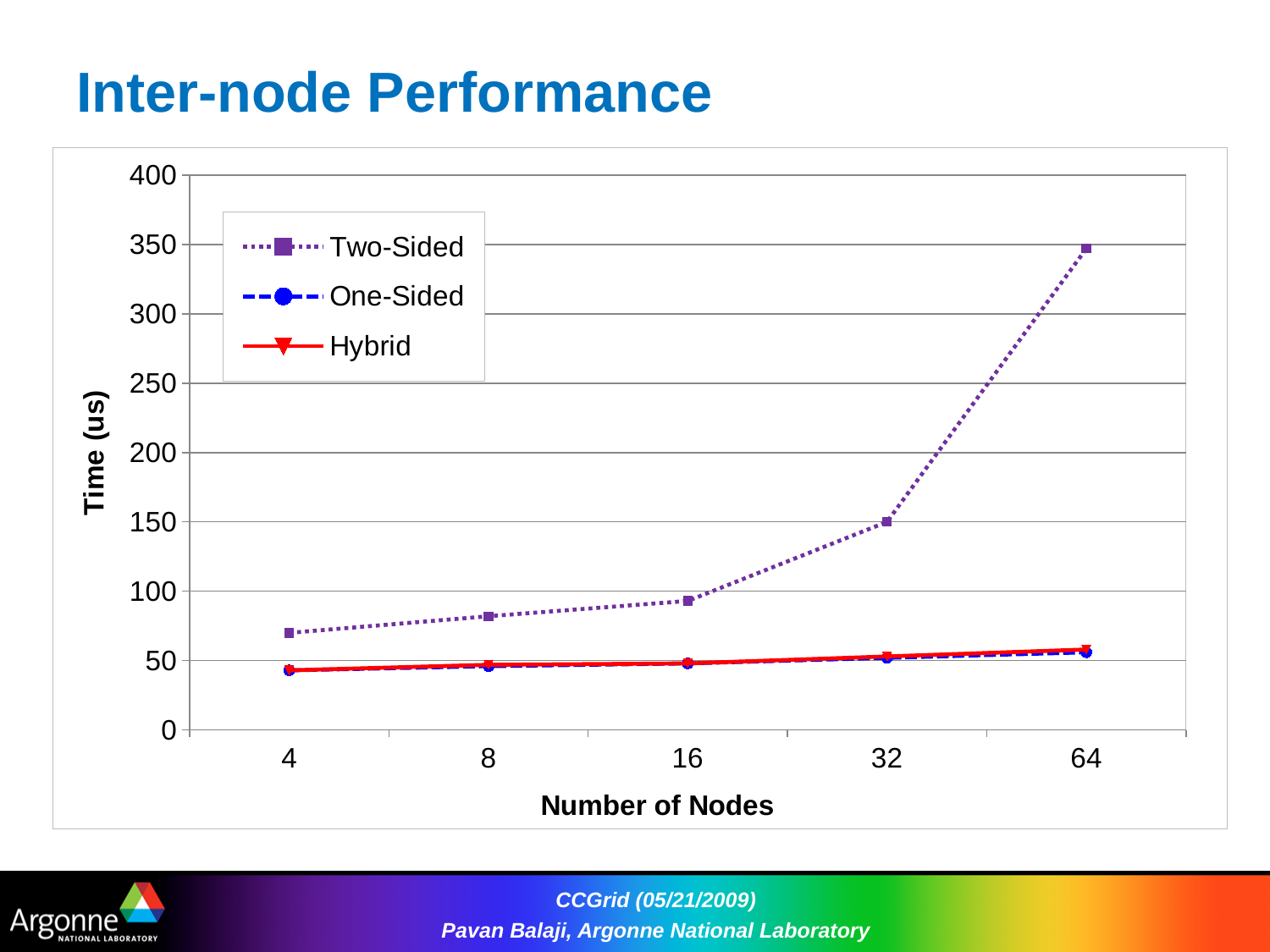
Is the Two-Sided time at 4 nodes greater or less than 50? greater How many series does the legend list? 3 What kind of chart is shown on the slide? line chart At 64 nodes, which is larger: the Two-Sided time or the Hybrid time? Two-Sided Is the One-Sided time at 64 nodes greater or less than 100? less Does the Two-Sided time rise or fall as the number of nodes increases? rise Is the Two-Sided time at 16 nodes greater or less than 100? less What is the title of the y axis? Time (us) Which series has the highest time at 64 nodes? Two-Sided How many node counts are plotted along the x axis? 5